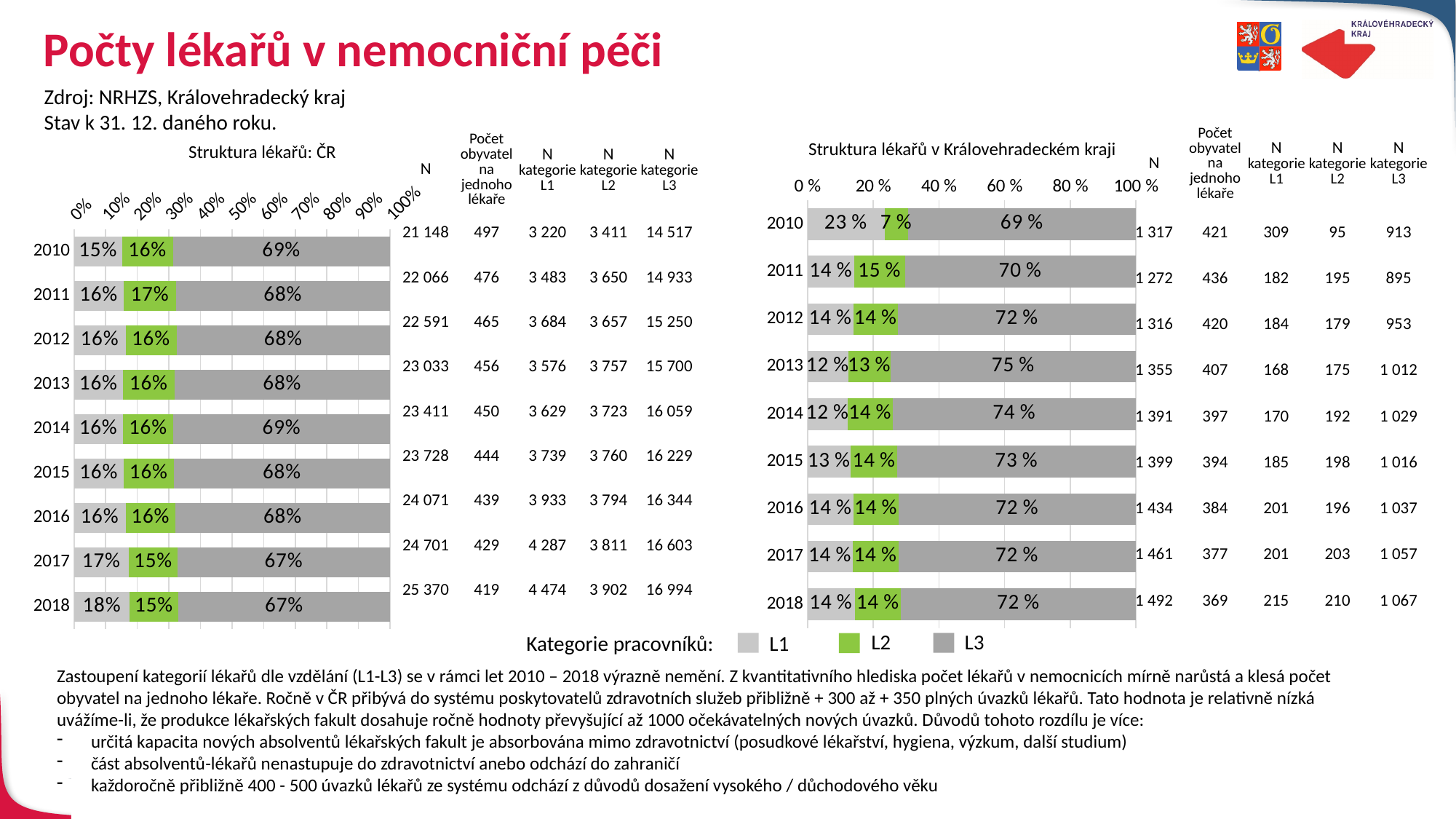
In the chart 'Struktura lékařů: ČR', what is the L2 share for 2011? 17% In the chart 'Struktura lékařů: ČR', by how many percentage points is the L1 share in 2018 higher than in 2010? 3 percentage points In the chart 'Struktura lékařů v Královehradeckém kraji', for 2010, which is larger: the L1 share or the L2 share? L1 In the chart 'Struktura lékařů: ČR', does the L1 share rise or fall from 2010 to 2018? Rises In the chart 'Struktura lékařů v Královehradeckém kraji', which year has the highest L3 share? 2013 In the chart 'Struktura lékařů: ČR', which year has the highest L1 share? 2018 In the chart 'Struktura lékařů: ČR', what is the L3 share for 2010? 69% What type of chart is 'Struktura lékařů v Královehradeckém kraji'? Stacked bar chart How many years are shown in the chart 'Struktura lékařů: ČR'? 9 In the chart 'Struktura lékařů v Královehradeckém kraji', what is the L1 share for 2010? 23 % In the chart 'Struktura lékařů v Královehradeckém kraji', which year has the lowest L2 share? 2010 How many categories does the legend 'Kategorie pracovníků' list? 3